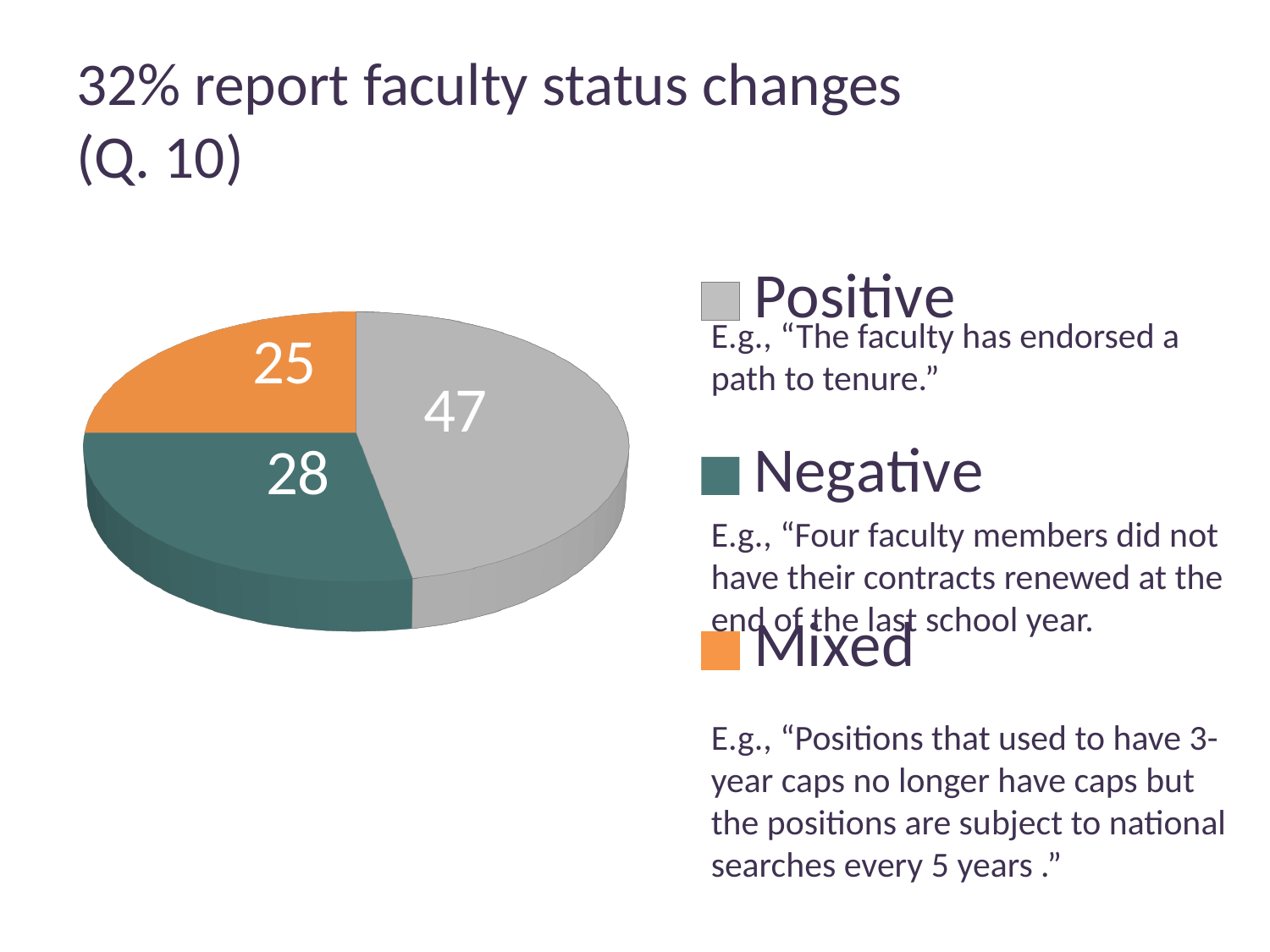
Which is larger, the Positive slice or the Mixed slice? Positive How many slices does the pie chart have? 3 What is the difference between the Negative and Mixed values? 3 What is the value of the Mixed slice? 25 Which category has the largest slice of the pie? Positive What is the value of the Positive slice? 47 What is the value of the Negative slice? 28 What colour is the Negative slice in the pie chart? teal What is the difference between the Positive and Negative values? 19 Which category has the smallest slice of the pie? Mixed What type of chart is shown on the slide? pie chart How many entries does the legend list? 3